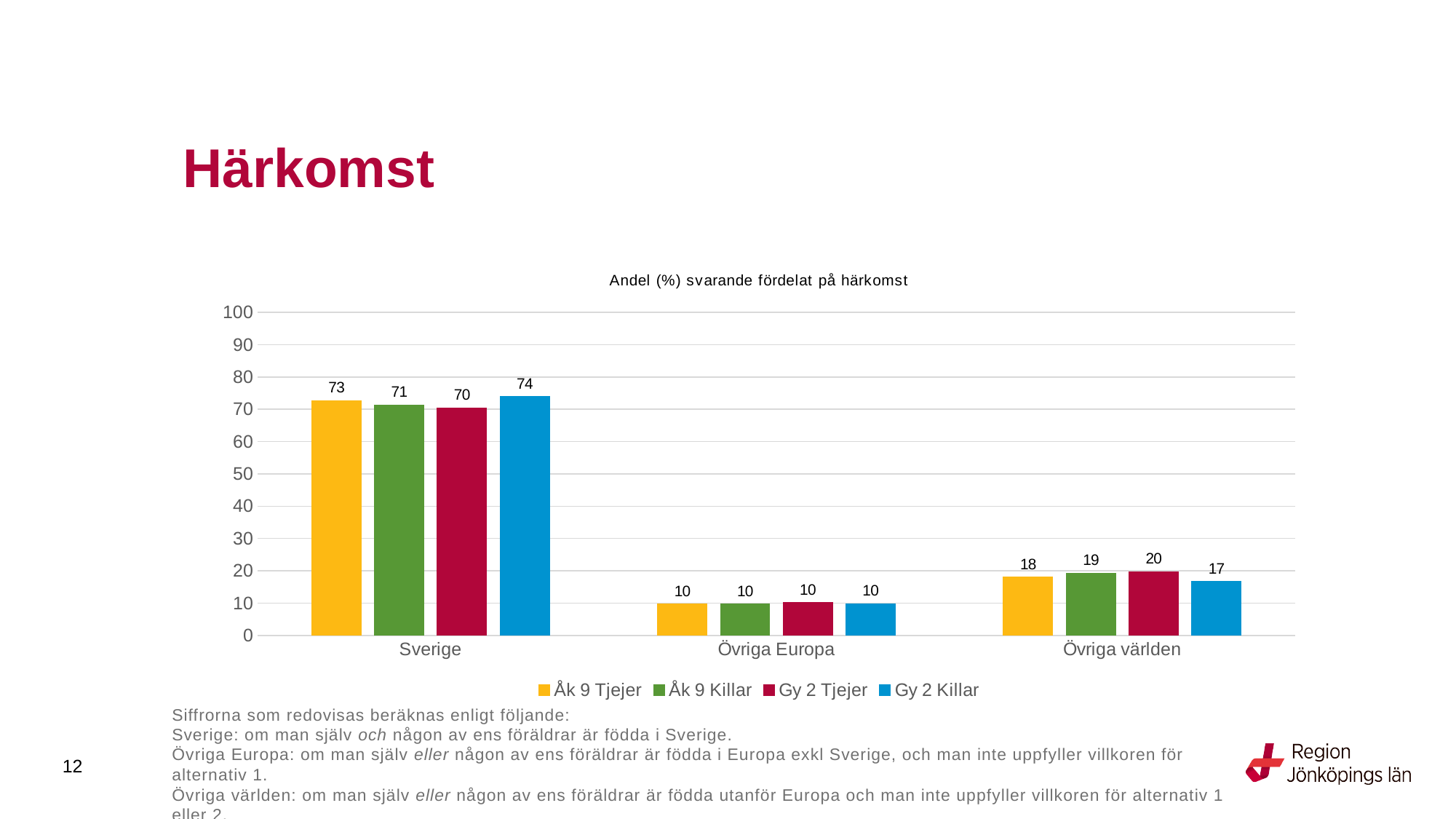
What kind of chart is shown on the slide? Bar chart What is the title of the chart? Andel (%) svarande fördelat på härkomst Which series has the lowest value in the Övriga världen category? Gy 2 Killar What is the value for Gy 2 Killar in the Sverige category? 74 What is the difference between the Åk 9 Tjejer value for Sverige and for Övriga världen? 55 How many categories are shown on the x axis? 3 What is the value for Gy 2 Tjejer in the Övriga Europa category? 10 Is the value for Åk 9 Killar in Sverige greater or less than 60? greater What is the value for Åk 9 Tjejer in the Övriga världen category? 18 How many series does the legend list? 4 Which is larger: the Gy 2 Tjejer value for Övriga världen or the Gy 2 Killar value for Övriga världen? Gy 2 Tjejer Which series has the highest value in the Sverige category? Gy 2 Killar